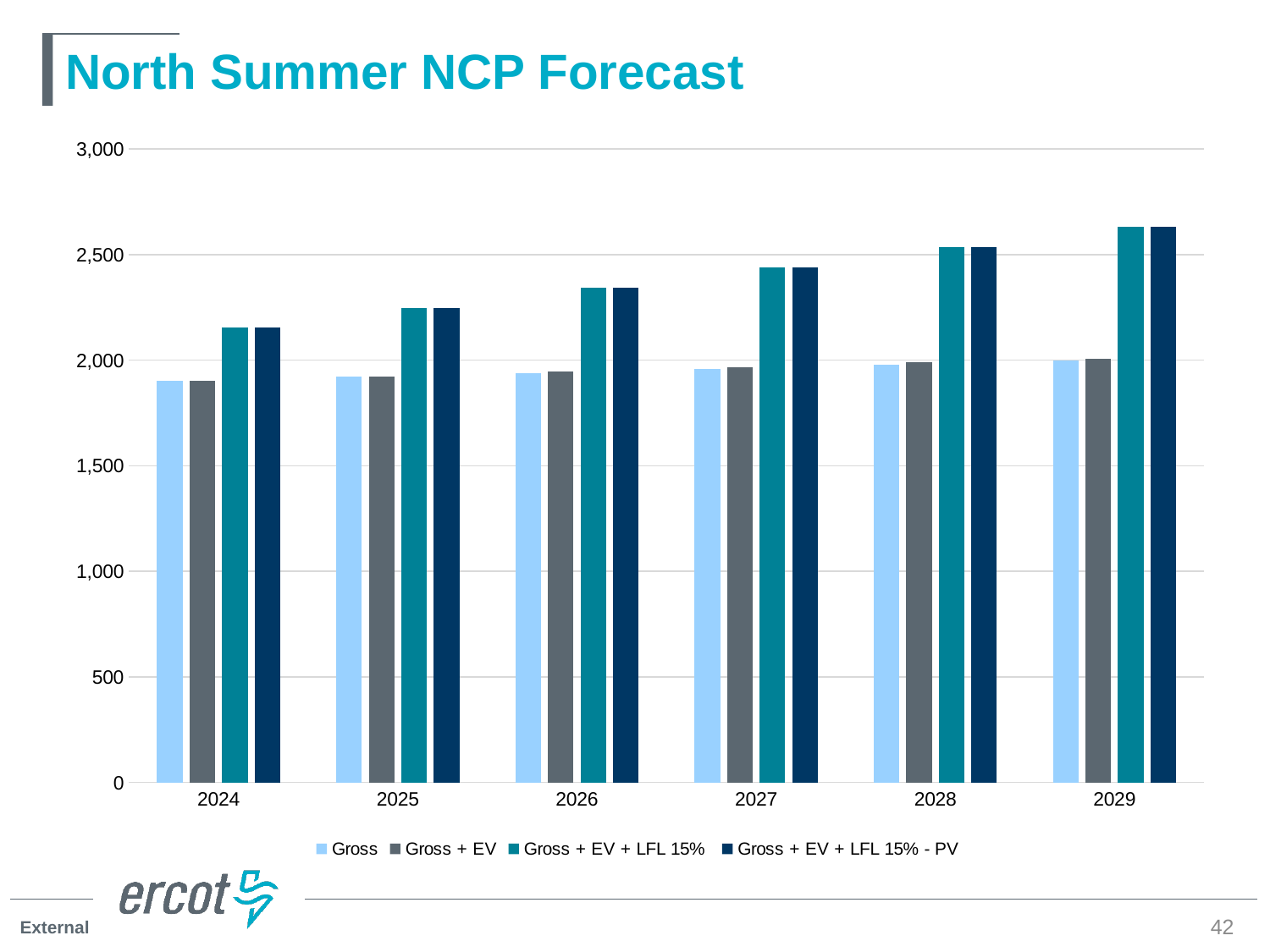
How many series does the legend list? 4 In 2026, which is larger: the Gross value or the Gross + EV + LFL 15% value? Gross + EV + LFL 15% Is the Gross + EV + LFL 15% - PV value for 2027 greater or less than 2,500? less How many years are shown on the x axis? 6 What kind of chart is shown on the slide? bar chart In which year is the Gross value lowest? 2024 What is the title of the chart? North Summer NCP Forecast Is the Gross + EV + LFL 15% value for 2029 greater or less than 2,500? greater Is the Gross value for 2024 greater or less than 2,000? less In which year is the Gross + EV + LFL 15% value highest? 2029 Do the Gross + EV + LFL 15% values rise or fall from 2024 to 2029? rise